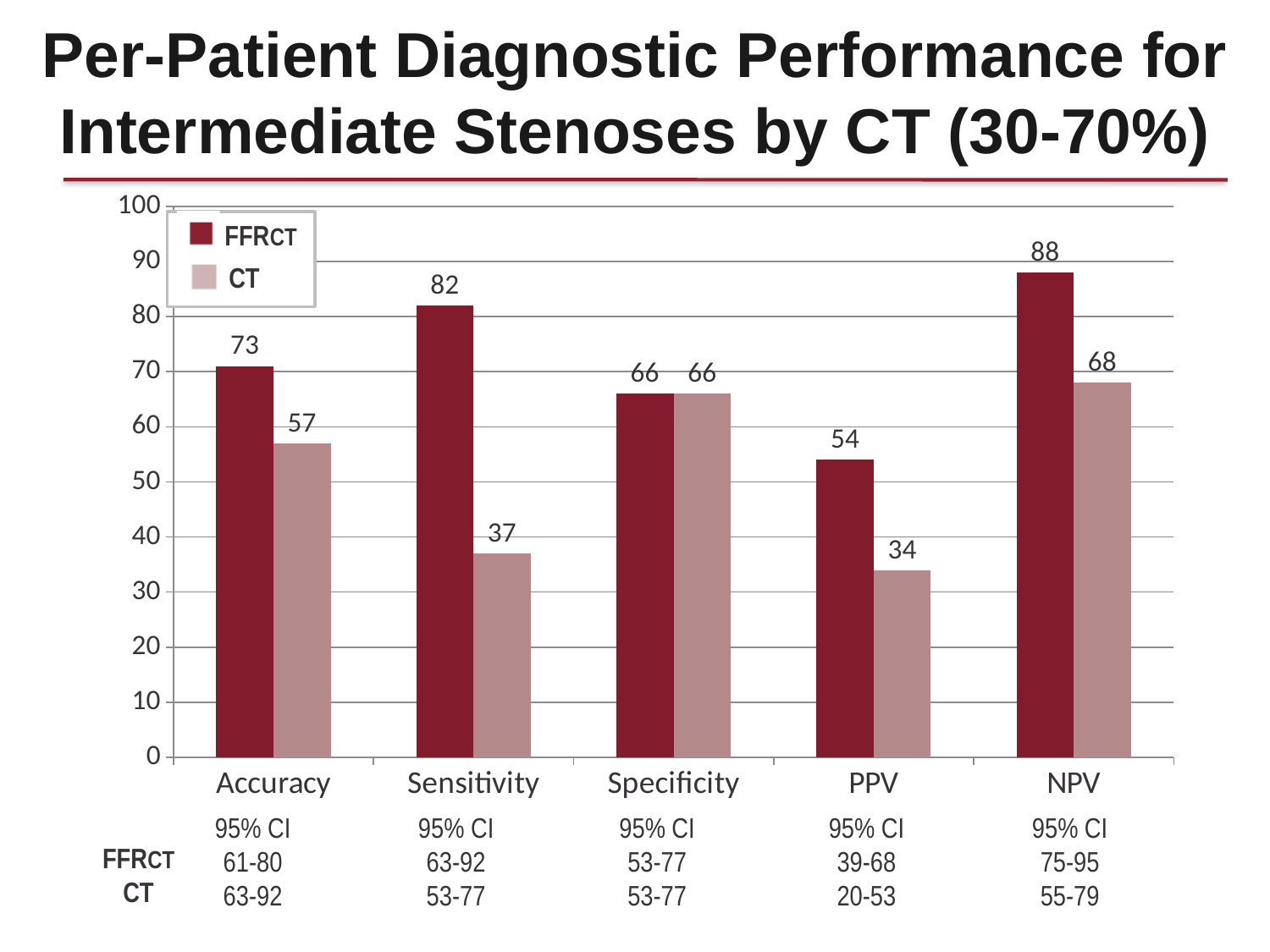
What is the CT value for PPV? 34 Which is larger for PPV, the FFRct value or the CT value? FFRct What is the difference between the FFRct and CT values for Sensitivity? 45 What kind of chart is shown on the slide? Bar chart How many categories are shown on the x axis? 5 How many series does the legend list? 2 Which series is shown in dark red in the legend? FFRct What is the CT value for NPV? 68 What is the FFRct value for Sensitivity? 82 Which category has the lowest CT value? PPV Which category has the highest FFRct value? NPV What is the difference between the FFRct and CT values for Accuracy? 16